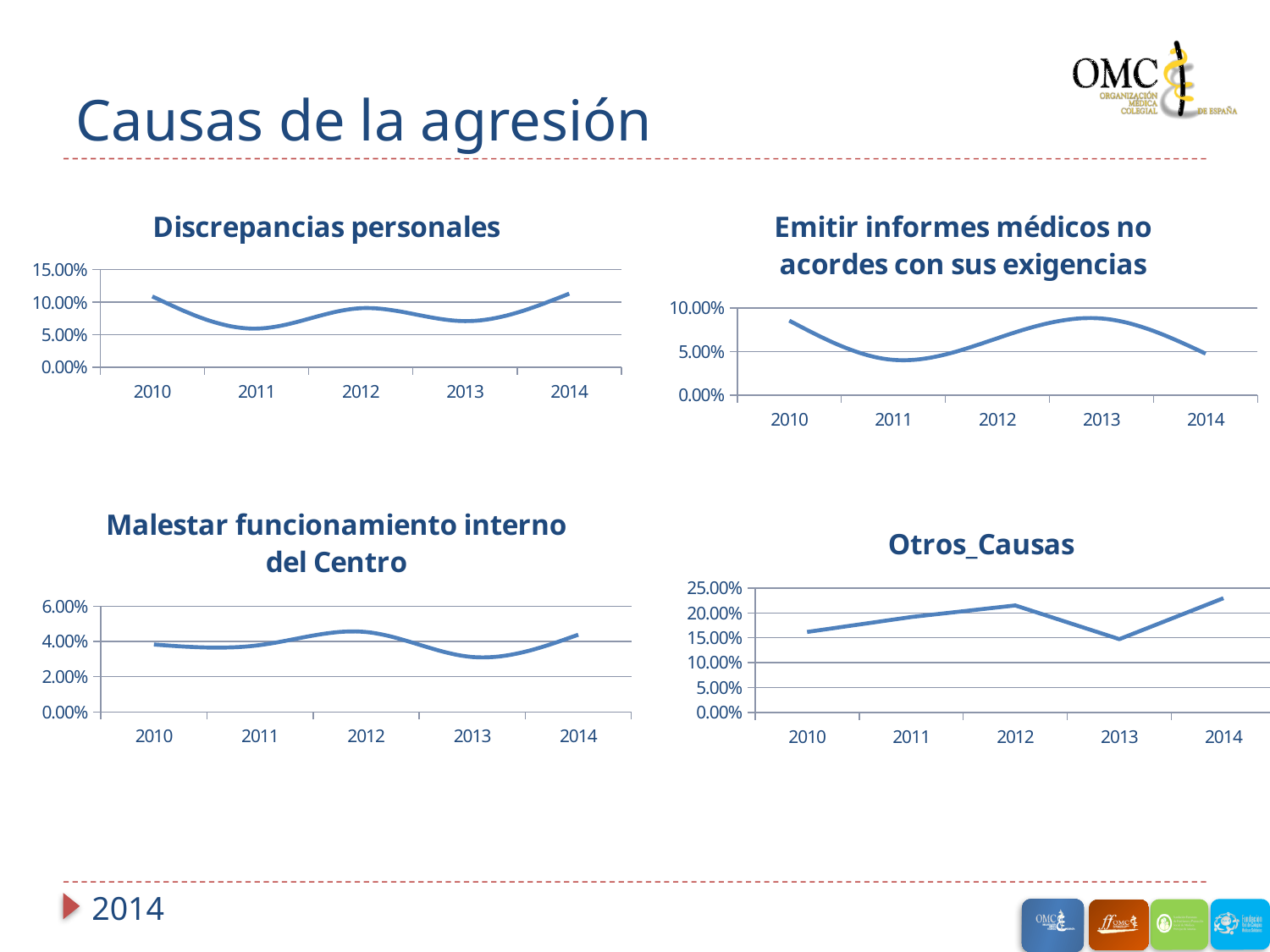
In the "Malestar funcionamiento interno del Centro" chart, which year has the lowest value? 2013 In the "Otros_Causas" chart, which year has the highest value? 2014 In the "Emitir informes médicos no acordes con sus exigencias" chart, is the value for 2010 greater or less than 5.00%? greater In the "Discrepancias personales" chart, is the value for 2011 greater or less than 10.00%? less In the "Emitir informes médicos no acordes con sus exigencias" chart, which year has the lowest value? 2011 In the "Otros_Causas" chart, is the value for 2013 greater or less than 20.00%? less How many years are plotted on the "Otros_Causas" chart? 5 In the "Otros_Causas" chart, which is larger, the value for 2012 or the value for 2013? 2012 How many charts are shown on the slide? 4 What kind of chart is the "Discrepancias personales" chart? line chart In the "Discrepancias personales" chart, which year has the lowest value? 2011